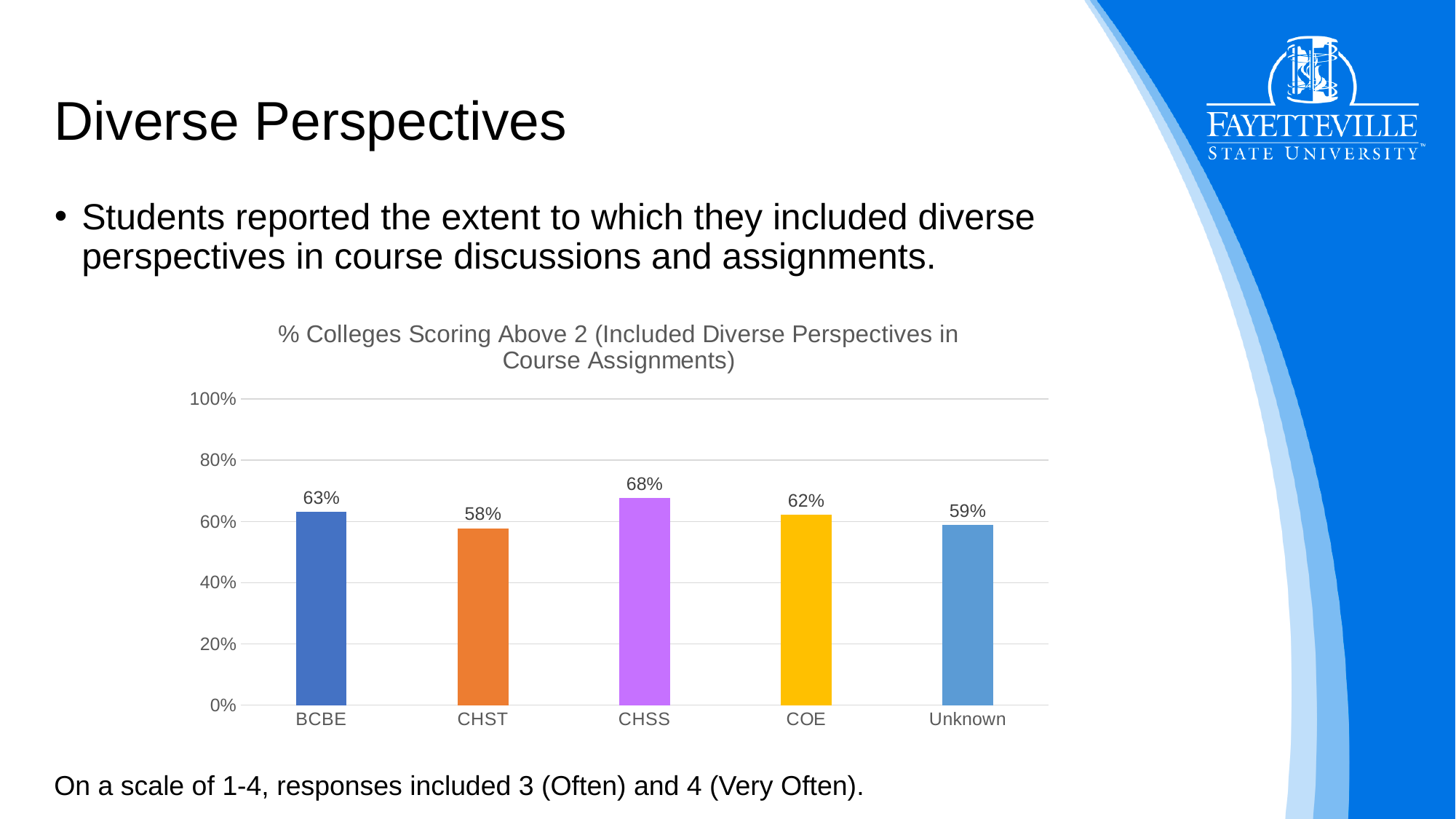
What is the value for CHST? 58% What is the value for BCBE? 63% Which is larger, the value for BCBE or the value for Unknown? BCBE What is the value for CHSS? 68% What is the value for Unknown? 59% Which category has the highest value? CHSS Which category has the lowest value? CHST What kind of chart is shown on the slide? bar chart Is the value for CHST greater or less than 60%? less How many categories are shown on the x axis? 5 What is the difference between the values for CHSS and CHST? 10% What is the value for COE? 62%